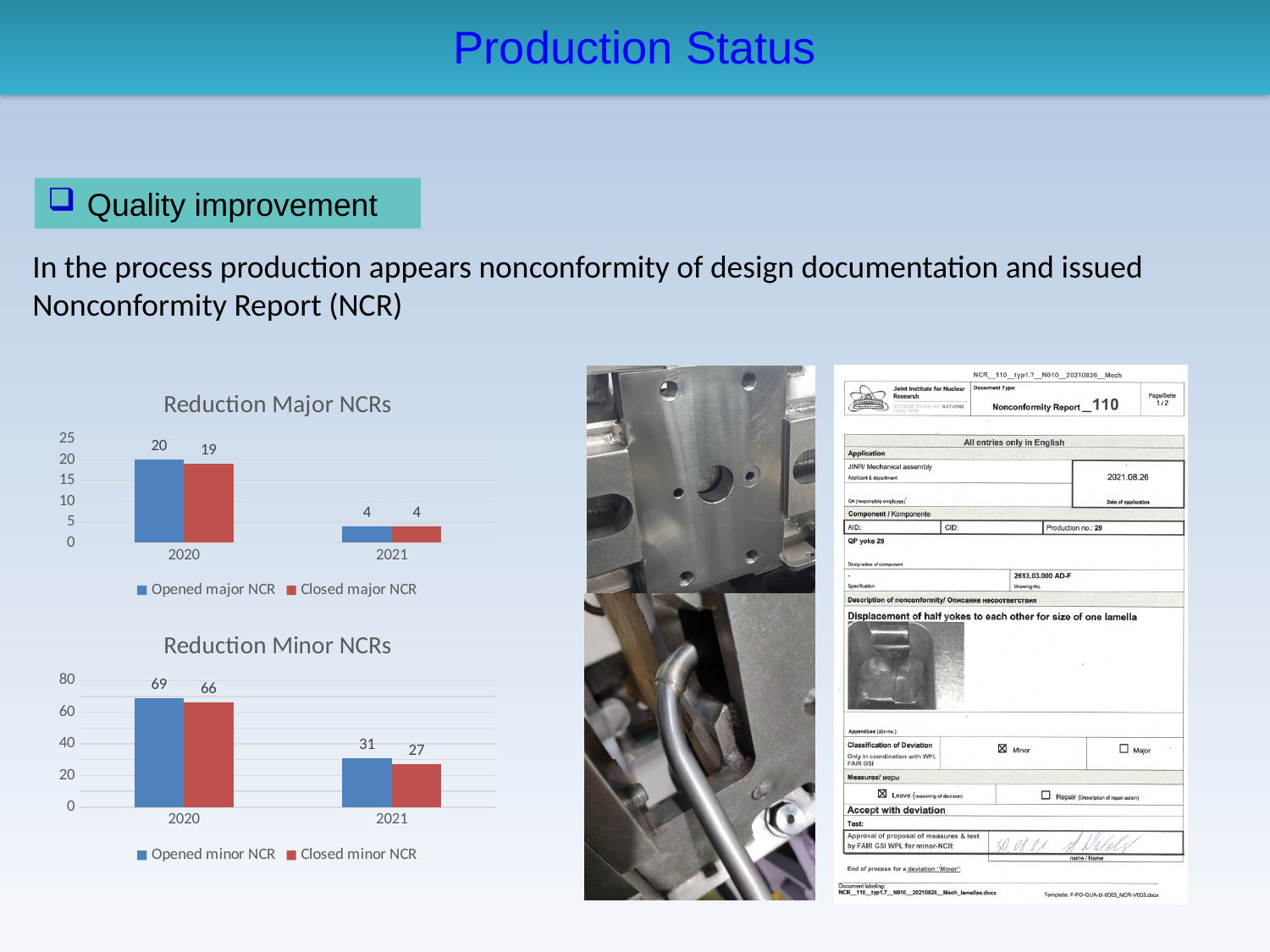
In the 'Reduction Minor NCRs' chart, is the value for Closed minor NCR in 2020 greater or less than 60? greater In the 'Reduction Major NCRs' chart, what is the value for Closed major NCR in 2021? 4 In the 'Reduction Major NCRs' chart, how many series does the legend list? 2 In the 'Reduction Minor NCRs' chart, what is the value for Closed minor NCR in 2021? 27 In the 'Reduction Minor NCRs' chart, what is the value for Opened minor NCR in 2020? 69 In the 'Reduction Minor NCRs' chart, what is the difference between Opened minor NCR and Closed minor NCR in 2021? 4 In the 'Reduction Minor NCRs' chart, which year has the higher value for Opened minor NCR? 2020 What kind of chart is 'Reduction Major NCRs'? Bar chart In the 'Reduction Major NCRs' chart, what is the difference between Opened major NCR in 2020 and Opened major NCR in 2021? 16 In the 'Reduction Minor NCRs' chart, do the Opened minor NCR values rise or fall from 2020 to 2021? Fall In the 'Reduction Major NCRs' chart, what is the value for Opened major NCR in 2020? 20 In the 'Reduction Minor NCRs' chart, how many categories are shown on the x axis? 2